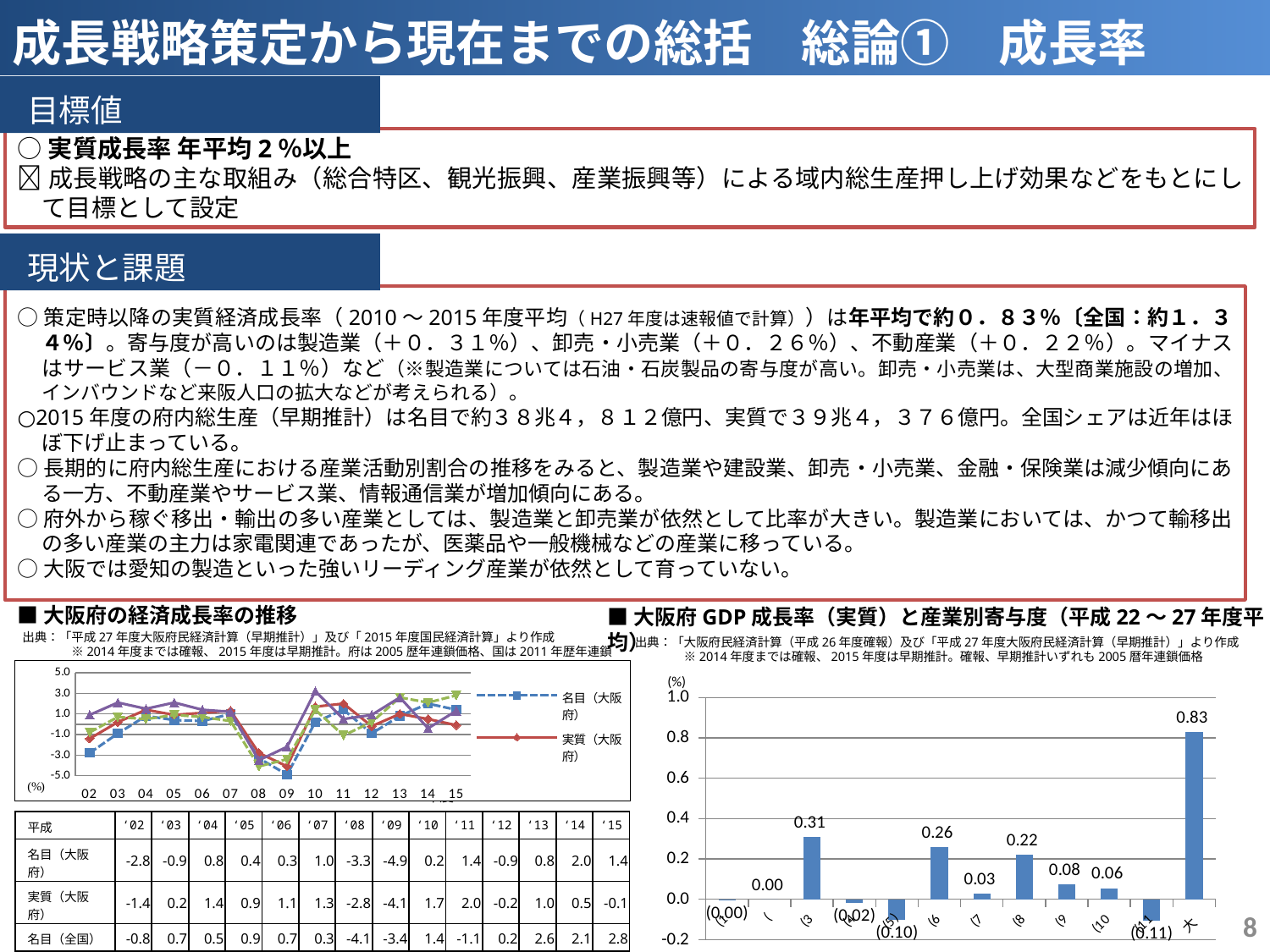
In the left chart 大阪府の経済成長率の推移, what is the difference between 名目（全国） and 名目（大阪府） for '15? 1.4 What kind of chart is the left chart titled 大阪府の経済成長率の推移? line chart In the left chart 大阪府の経済成長率の推移, how many years are shown on the x axis? 14 In the right chart 大阪府GDP成長率（実質）と産業別寄与度, how many bars are plotted? 12 In the left chart 大阪府の経済成長率の推移, in which year is 名目（大阪府） highest? '14 In the left chart 大阪府の経済成長率の推移, which is larger for '10: 名目（大阪府） or 実質（大阪府）? 実質（大阪府） In the left chart 大阪府の経済成長率の推移, in which year is 実質（大阪府） lowest? '09 In the left chart 大阪府の経済成長率の推移, what is the value of 名目（大阪府） for '09? -4.9 In the left chart 大阪府の経済成長率の推移, what is the value of 名目（全国） for '13? 2.6 In the left chart 大阪府の経済成長率の推移, what is the value of 実質（大阪府） for '11? 2.0 In the right chart 大阪府GDP成長率（実質）と産業別寄与度, what is the value of the tallest bar? 0.83 What kind of chart is the right chart titled 大阪府GDP成長率（実質）と産業別寄与度? bar chart